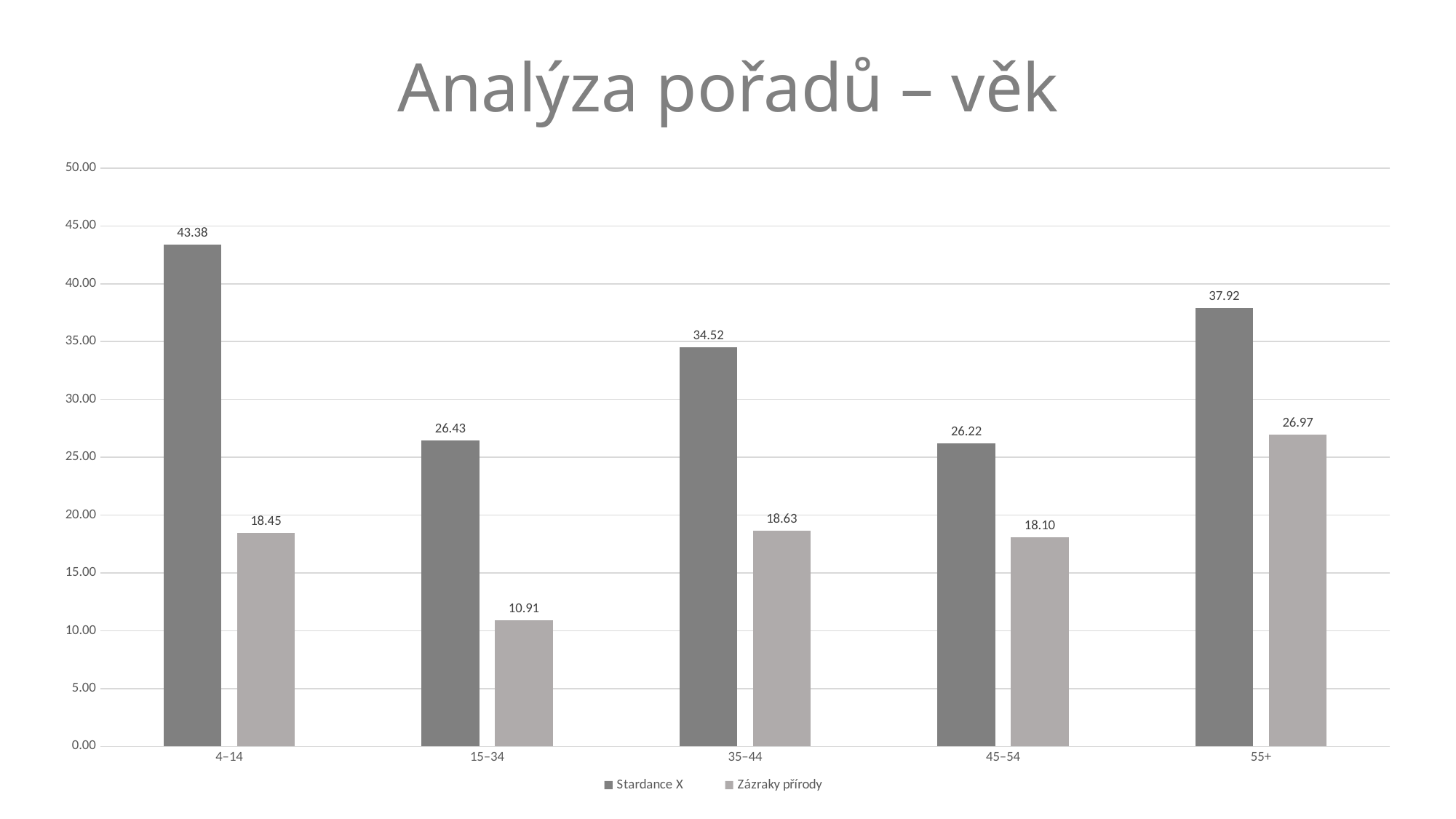
How many age groups are shown on the x axis? 5 Which is larger in the 45–54 age group, Stardance X or Zázraky přírody? Stardance X Which age group has the lowest value for Zázraky přírody? 15–34 What is the value for Zázraky přírody in the 55+ age group? 26.97 What is the title of the chart? Analýza pořadů – věk What is the value for Zázraky přírody in the 15–34 age group? 10.91 What is the difference between Stardance X and Zázraky přírody in the 35–44 age group? 15.89 Which age group has the highest value for Stardance X? 4–14 What kind of chart is shown on the slide? bar chart How many series does the legend list? 2 Is the value for Stardance X in the 55+ age group greater or less than 35.00? greater What is the value for Stardance X in the 4–14 age group? 43.38